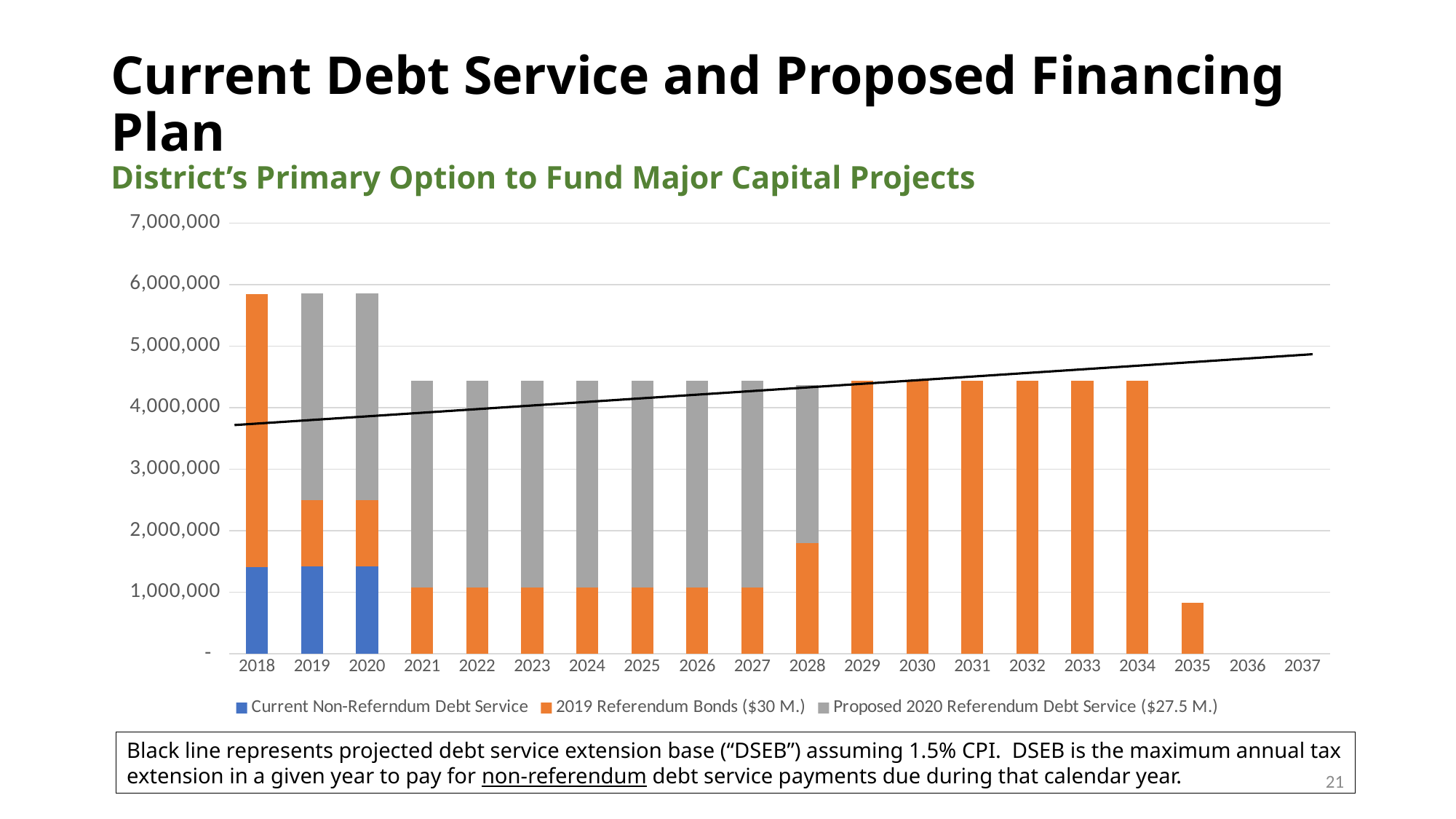
In how many years does the Current Non-Referndum Debt Service series appear? 3 What kind of chart is shown on the slide? Stacked bar chart Is the value for 2035 greater or less than 1,000,000? less How many years are shown on the x axis? 20 Which year has the taller total bar, 2018 or 2021? 2018 Which series is shown in gray in the legend? Proposed 2020 Referendum Debt Service ($27.5 M.) According to the note on the slide, what does the black line represent? Projected debt service extension base ("DSEB") assuming 1.5% CPI Is the total bar height for 2021 greater or less than 4,000,000? greater Is the Current Non-Referndum Debt Service value for 2018 greater or less than 1,000,000? greater Which year has the taller bar, 2034 or 2035? 2034 How many series does the legend list? 3